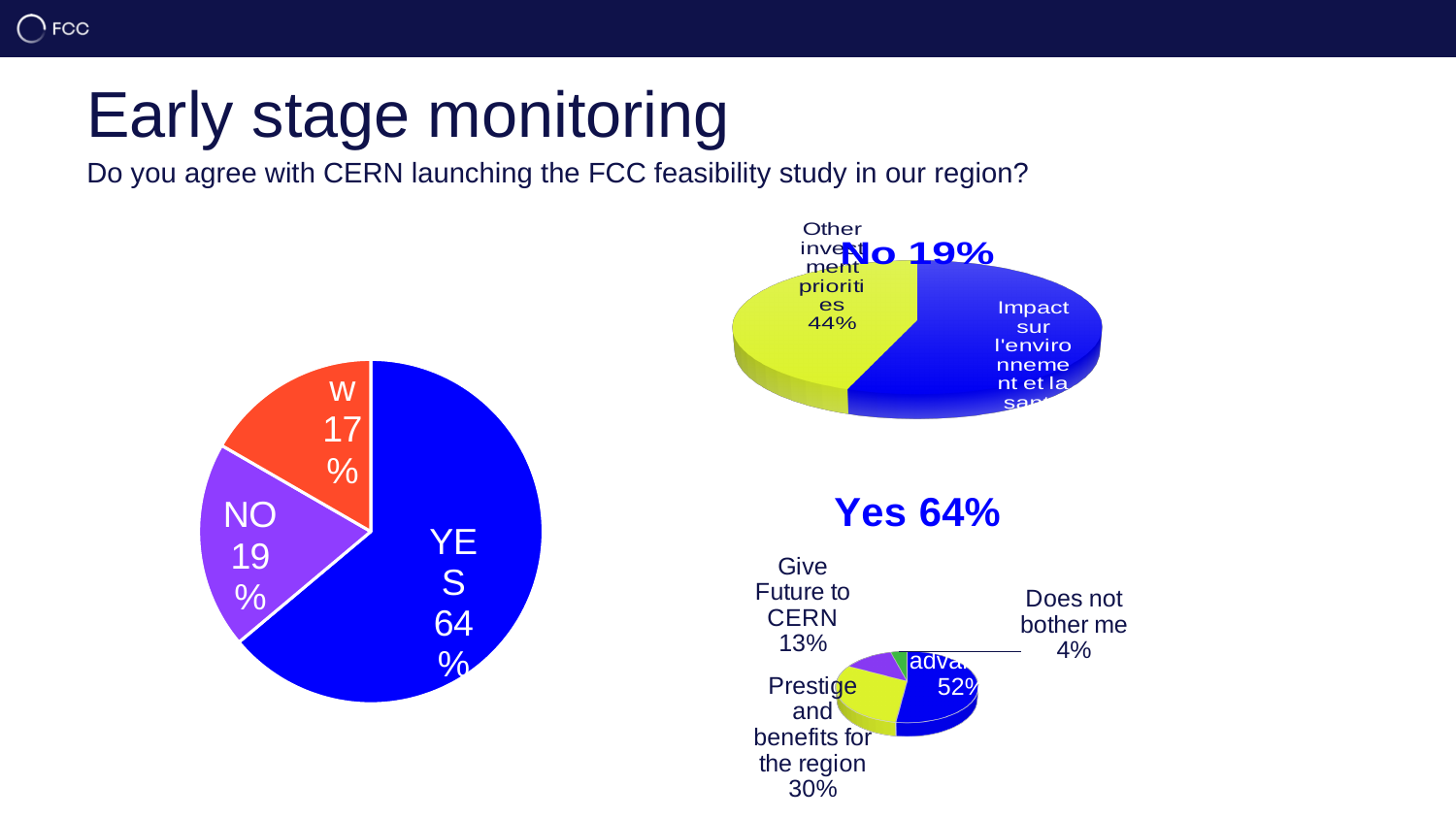
In the large pie chart on the left, which answer has the largest share? YES In the bottom-right pie chart labelled 'Yes 64%', what share is attributed to 'Does not bother me'? 4% In the bottom-right pie chart labelled 'Yes 64%', what share is attributed to 'Prestige and benefits for the region'? 30% In the top-right pie chart labelled 'No 19%', what share is attributed to 'Other investment priorities'? 44% In the bottom-right pie chart labelled 'Yes 64%', which is larger: 'Prestige and benefits for the region' or 'Give Future to CERN'? Prestige and benefits for the region In the large pie chart on the left, what share of respondents answered NO? 19% In the large pie chart on the left, what is the difference in percentage points between the YES and NO shares? 45 In the large pie chart on the left, what share of respondents answered YES? 64% What survey question is shown above the charts on the slide? Do you agree with CERN launching the FCC feasibility study in our region? What kind of chart is the large chart on the left of the slide? Pie chart In the large pie chart on the left, how many slices does the pie have? 3 In the bottom-right pie chart labelled 'Yes 64%', which labelled reason has the smallest share? Does not bother me